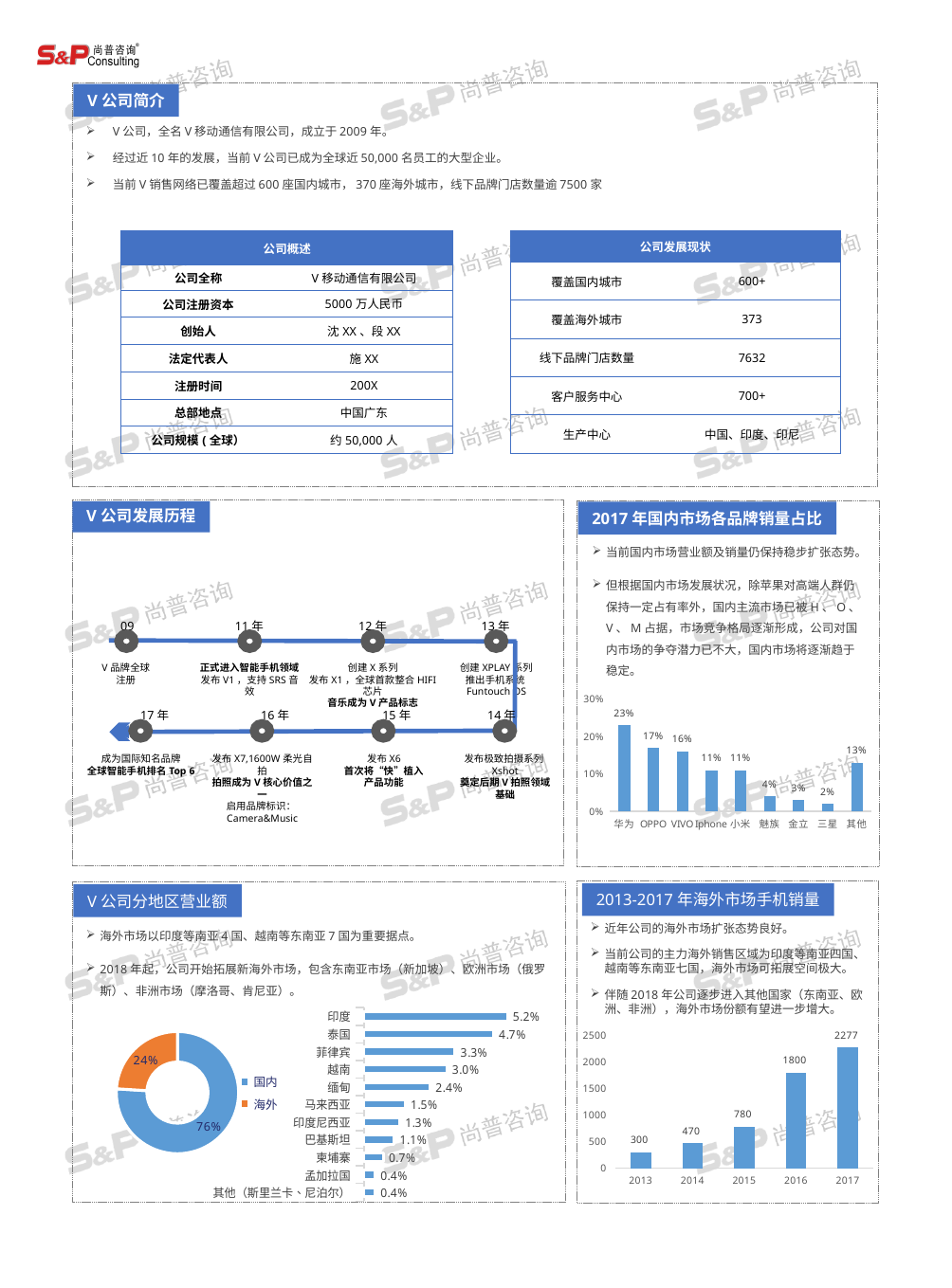
In the chart titled 2017年国内市场各品牌销量占比, which brand has the highest share? 华为 In the chart titled 2013-2017年海外市场手机销量, what is the value for 2016? 1800 In the horizontal bar chart under V公司分地区营业额, which country has the highest value? 印度 In the chart titled 2017年国内市场各品牌销量占比, what is the difference between OPPO and VIVO? 1% In the chart titled 2017年国内市场各品牌销量占比, how many brands are shown on the x axis? 9 In the chart titled 2013-2017年海外市场手机销量, do the values rise or fall from 2013 to 2017? rise In the chart titled 2017年国内市场各品牌销量占比, which brand has the lowest share? 三星 In the donut chart under V公司分地区营业额, what share is 海外? 24% In the chart titled 2013-2017年海外市场手机销量, what is the difference between 2017 and 2016? 477 In the chart titled 2017年国内市场各品牌销量占比, what is the value for 华为? 23% In the horizontal bar chart under V公司分地区营业额, what is the value for 泰国? 4.7% In the chart titled 2013-2017年海外市场手机销量, what kind of chart is it? bar chart